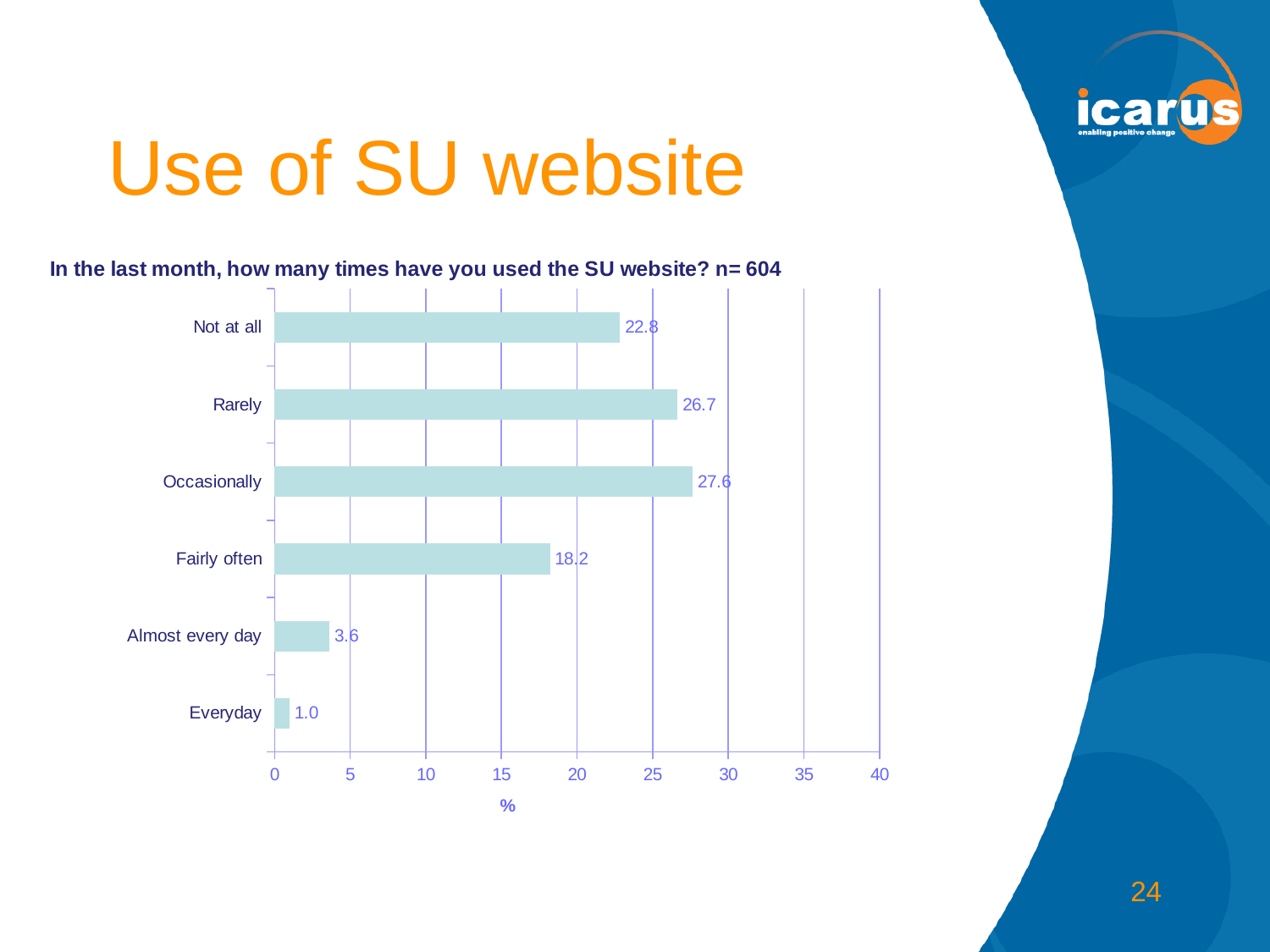
What is the value for "Everyday"? 1.0 What kind of chart is shown on the slide? bar chart What is the sample size (n) stated in the chart title? 604 Which category has the highest value? Occasionally Which is larger, the value for "Not at all" or the value for "Fairly often"? Not at all What is the value for "Almost every day"? 3.6 What is the difference between the values for "Rarely" and "Not at all"? 3.9 How many categories are shown in the chart? 6 Which category has the lowest value? Everyday What is the value for "Fairly often"? 18.2 Is the value for "Rarely" greater or less than 25? greater What is the value for "Not at all"? 22.8